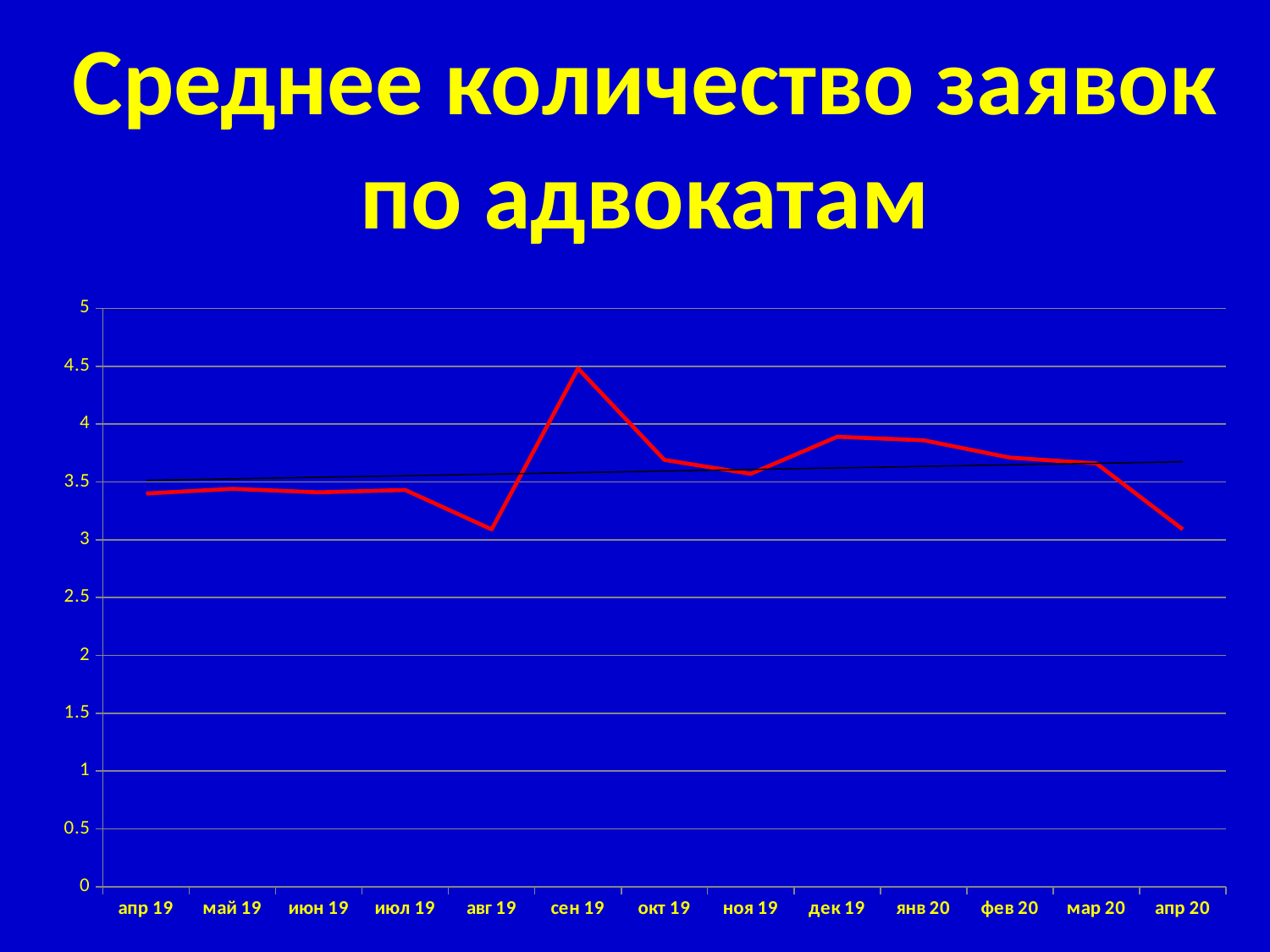
Which is larger, the value for сен 19 or the value for окт 19? сен 19 Which is larger, the value for дек 19 or the value for авг 19? дек 19 Is the value for дек 19 greater or less than 3.5? greater Is the value for апр 19 greater or less than 4? less Is the value for авг 19 greater or less than 3.5? less How many months are plotted along the x axis? 13 What is the title of the chart? Среднее количество заявок по адвокатам What kind of chart is shown on the slide? line chart Does the red line rise or fall from мар 20 to апр 20? fall Which month has the highest value on the red line? сен 19